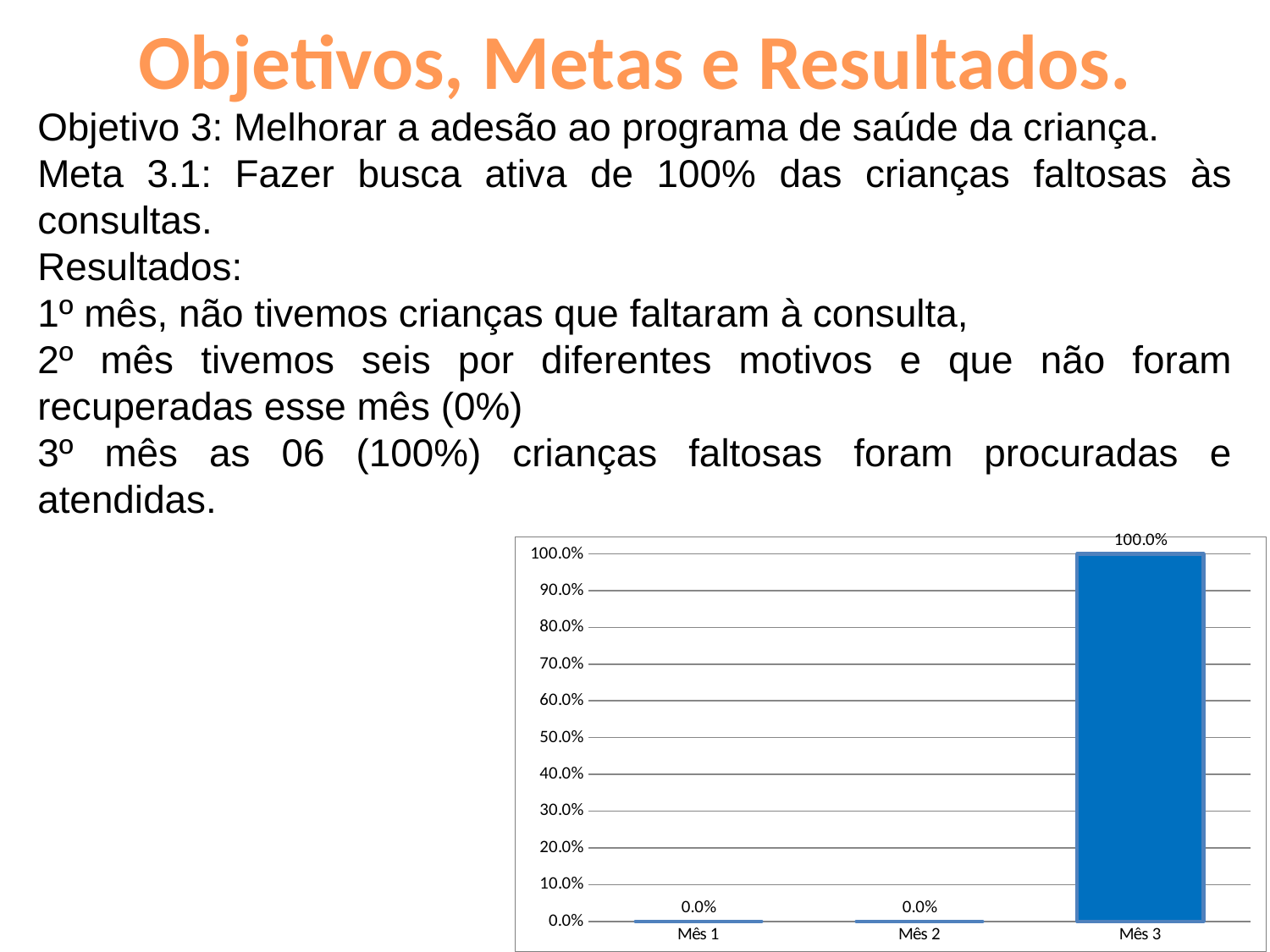
What is the value for Mês 3? 100.0% Is the value for Mês 3 greater or less than 50.0%? greater What is the value for Mês 2? 0.0% What kind of chart is shown on the slide? bar chart What is the difference between the values for Mês 3 and Mês 2? 100.0% Which is larger, the value for Mês 3 or the value for Mês 1? Mês 3 What is the value for Mês 1? 0.0% How many categories are shown on the x axis? 3 What is the highest tick label on the y axis? 100.0% What colour are the bars in the chart? blue Which category has the highest value? Mês 3 Do the values rise or fall from Mês 1 to Mês 3? rise